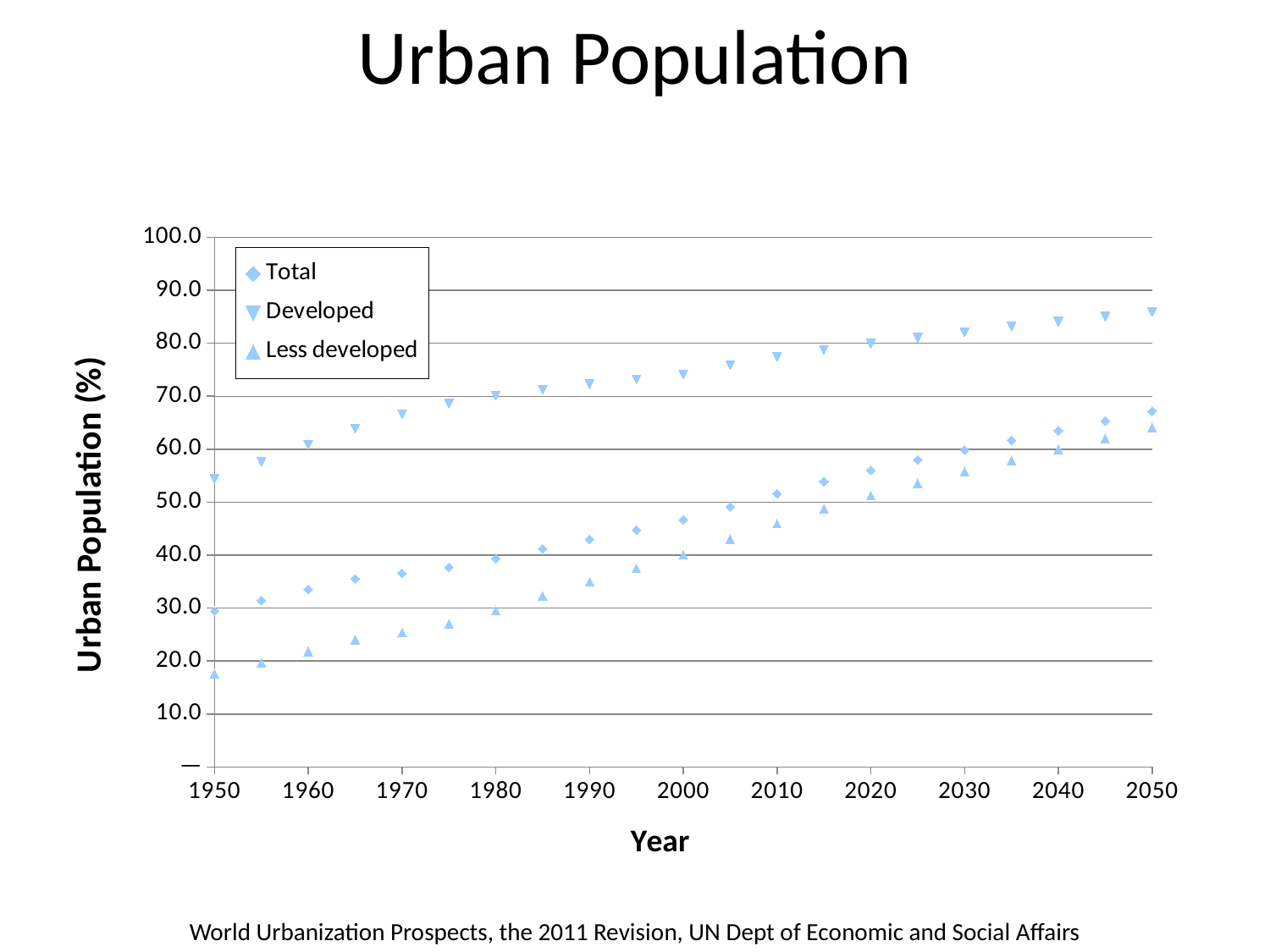
Is the value for Less developed in 1950 greater or less than 20? less Is the value for Developed in 2050 greater or less than 80? greater Is the value for Total in 2000 greater or less than 50? less How many data points does the Total series have? 21 How many series does the legend list? 3 What kind of chart is shown on the slide? scatter chart What is the title of the vertical axis? Urban Population (%) Do the values for the Developed series rise or fall from 1950 to 2050? rise In 2000, which is larger: the value for Developed or the value for Less developed? Developed Which series has the lowest value in 1950? Less developed